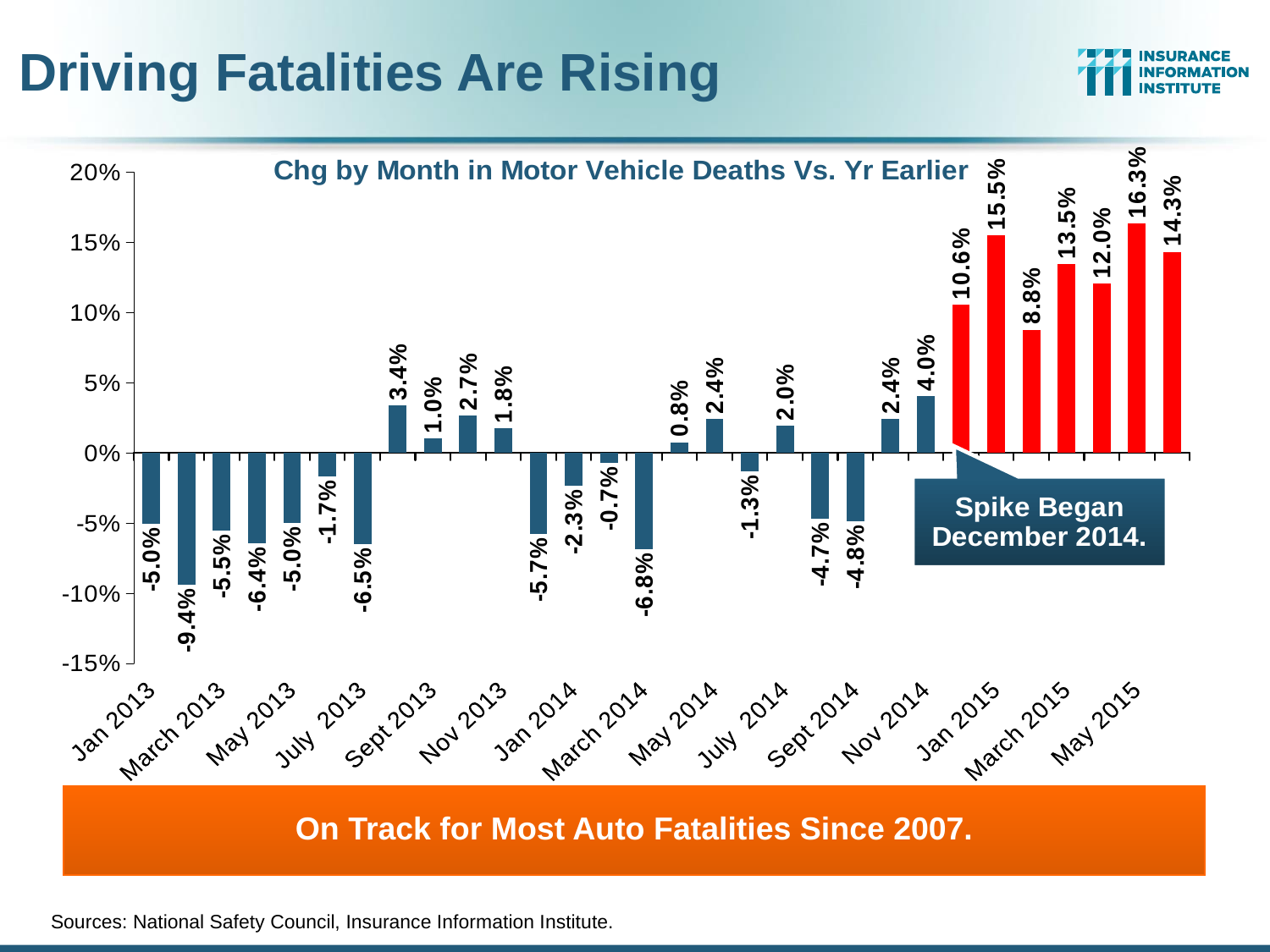
Which is larger, the value for Sept 2013 or Nov 2013? Nov 2013 What is the lowest value shown on the chart? -9.4% What is the value for Nov 2014? 4.0% How many bars are plotted on the chart? 30 What kind of chart is shown? Bar chart What is the title of the chart? Chg by Month in Motor Vehicle Deaths Vs. Yr Earlier What is the value for Jan 2015? 15.5% What is the difference between the values for Jan 2015 and Jan 2014? 17.8 percentage points What is the value for Jan 2013? -5.0% What is the value for May 2015? 16.3% Which labeled month has the highest value? May 2015 What is the value for March 2014? -6.8%